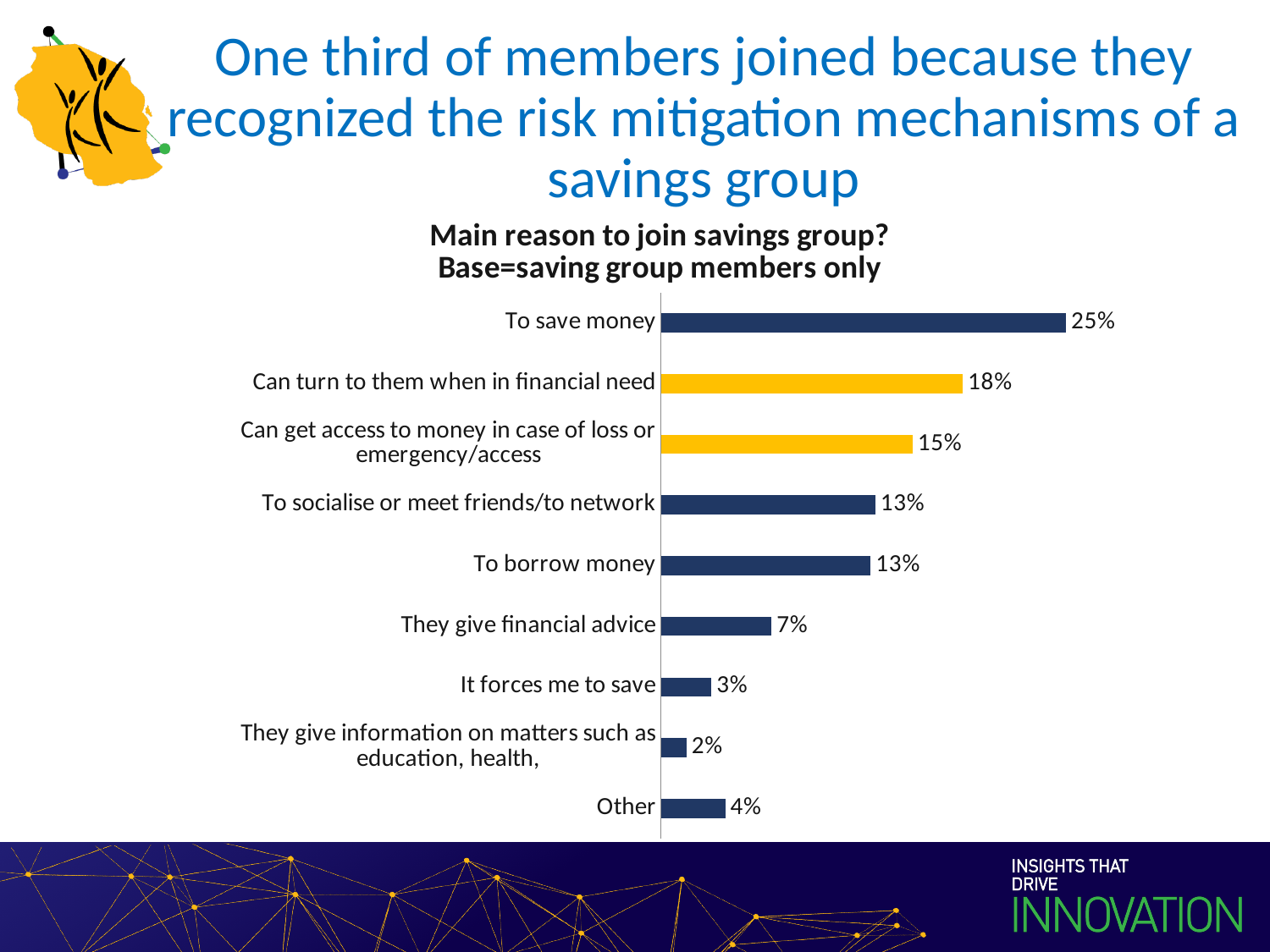
What percentage is shown for 'They give financial advice'? 7% What is the title of the chart? Main reason to join savings group? Base=saving group members only Which reason has the lowest percentage? They give information on matters such as education, health, What is the value for 'Can turn to them when in financial need'? 18% What is the value for 'Other'? 4% Which reason has the highest percentage? To save money What is the combined percentage of the two yellow-highlighted bars? 33% What is the difference in percentage points between 'To save money' and 'Can turn to them when in financial need'? 7 What type of chart is shown on the slide? Bar chart What percentage of members gave 'To save money' as their main reason to join a savings group? 25% How many reasons (categories) are shown in the chart? 9 Which is larger: the value for 'It forces me to save' or the value for 'Other'? Other